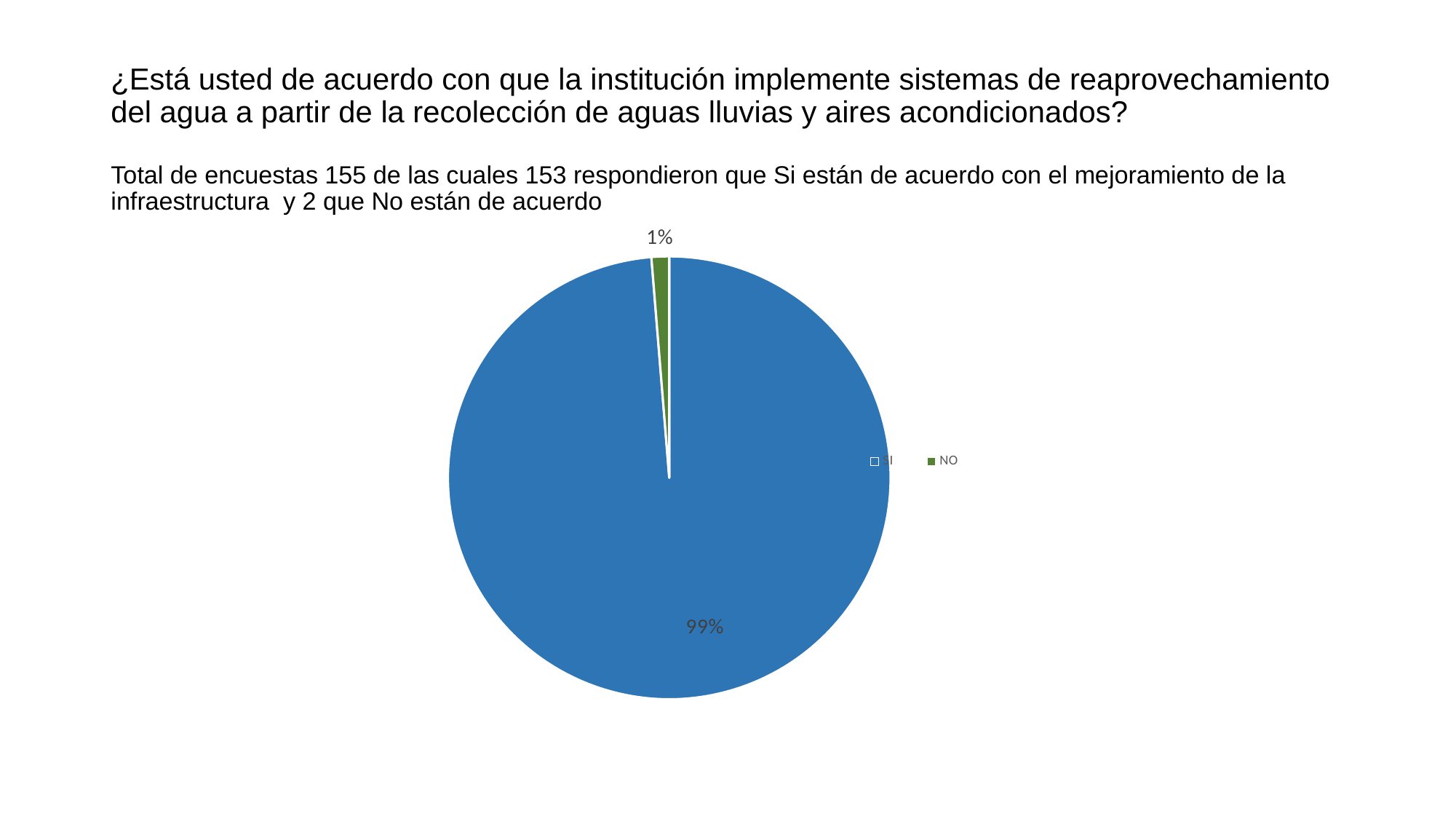
What colour is the NO slice in the pie chart? green What percentage does the largest slice of the pie chart show? 99% What kind of chart is shown on the slide? pie chart How many entries does the legend of the pie chart list? 2 According to the text above the chart, how many surveys were collected in total? 155 Which legend entry corresponds to the smallest slice of the pie chart? NO What is the difference in percentage points between the blue slice and the NO slice? 98 percentage points How many slices does the pie chart have? 2 What percentage is shown on the large blue slice of the pie chart? 99% What percentage does the NO slice of the pie chart represent? 1% Is the NO slice larger or smaller than the blue slice? smaller